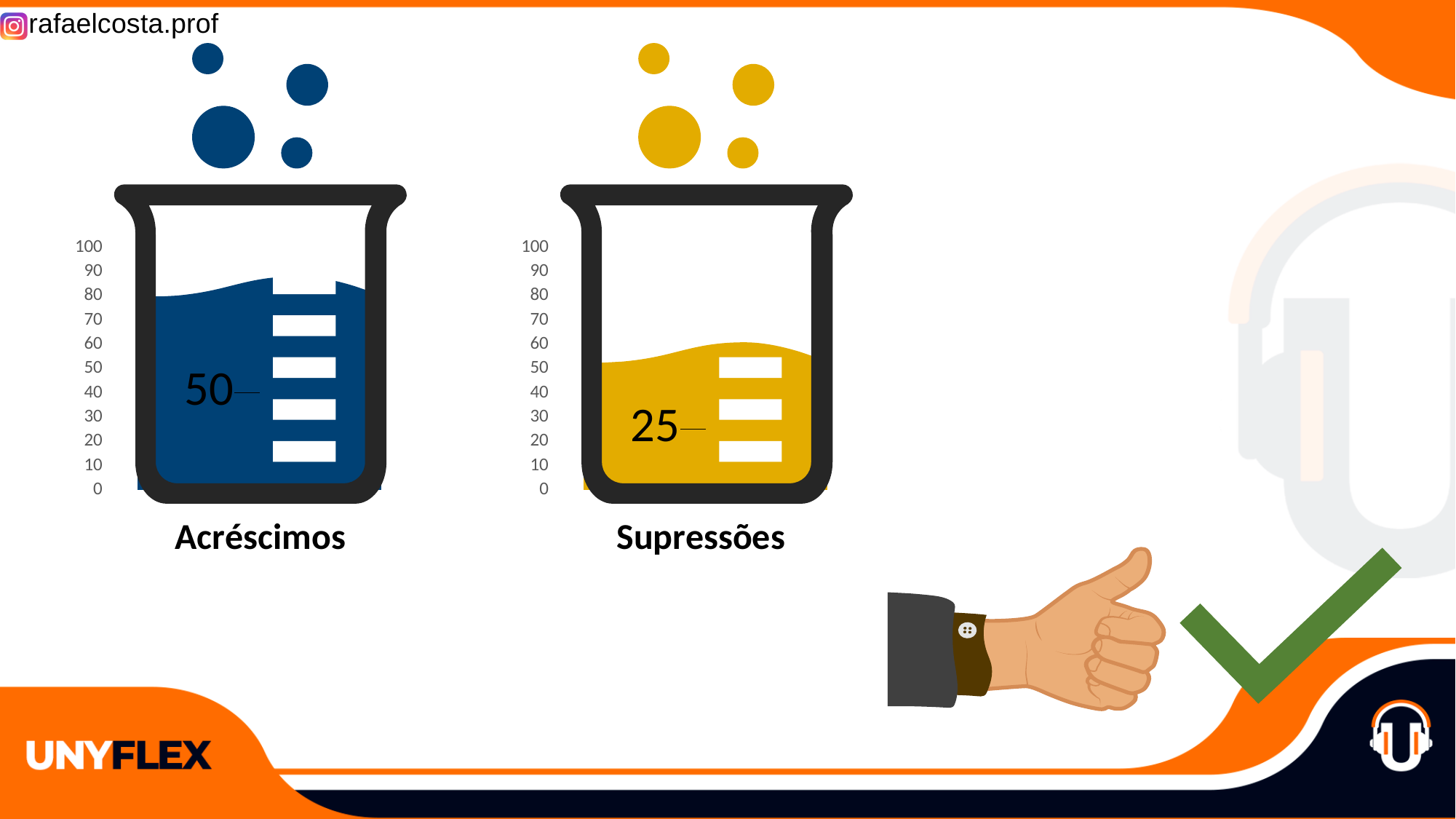
In the Acréscimos chart, what value is printed on the beaker? 50 What colour is the fill in the Supressões chart? Yellow Which of the two charts, Acréscimos or Supressões, shows the higher value? Acréscimos Which is larger, the value for Acréscimos or the value for Supressões? Acréscimos How many charts are shown on the slide? 2 Which of the two charts, Acréscimos or Supressões, shows the lower value? Supressões In the Supressões chart, what value is printed on the beaker? 25 What is the highest tick value on the axis of the Acréscimos chart? 100